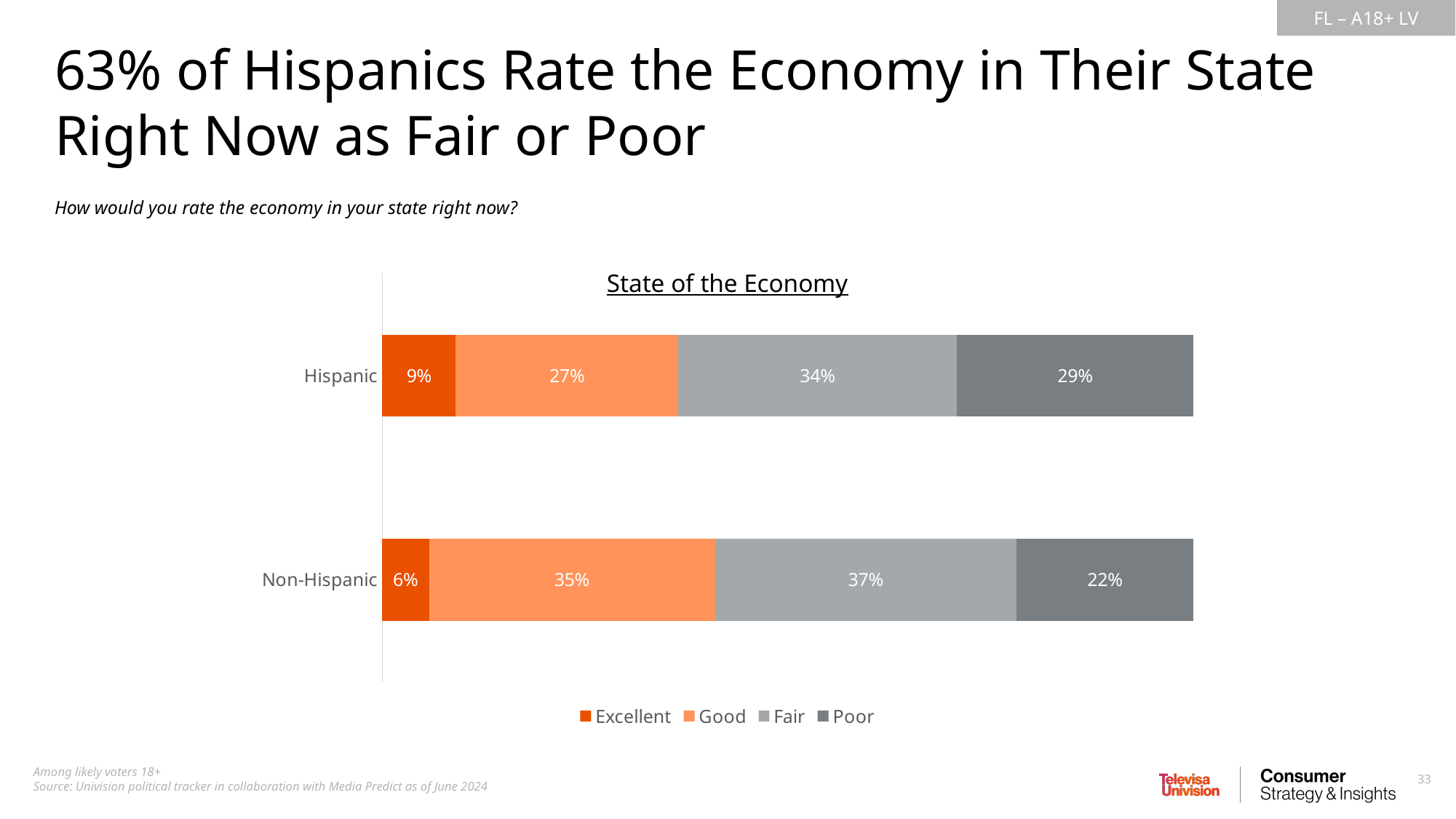
Which rating has the largest share among Hispanic respondents? Fair What percentage of Non-Hispanic respondents rate the economy as Poor? 22% What is the title of the chart? State of the Economy What percentage of Hispanic respondents rate the economy as Excellent? 9% What kind of chart is shown on the slide? Stacked bar chart How many series does the legend list? 4 What is the difference between the Poor share for Hispanic and Non-Hispanic respondents? 7 percentage points What percentage of Non-Hispanic respondents rate the economy in their state as Good? 35% What percentage of Hispanic respondents rate the economy in their state as Fair? 34% Which rating has the smallest share among Non-Hispanic respondents? Excellent Which group has a larger Good share, Hispanic or Non-Hispanic? Non-Hispanic What is the combined Fair and Poor share for Hispanic respondents? 63%